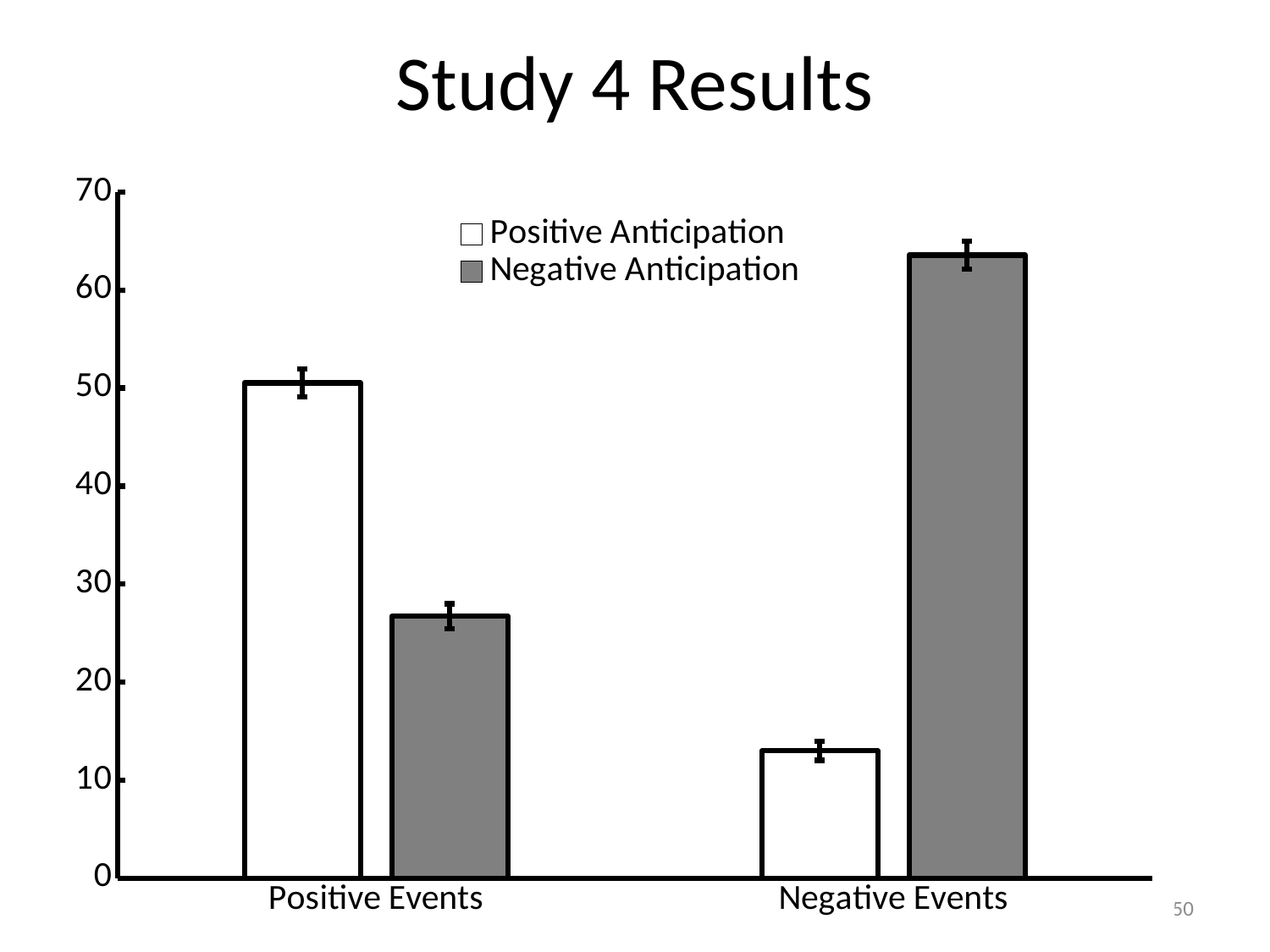
Is the value for Positive Anticipation in Negative Events greater or less than 20? less Is the value for Negative Anticipation in Positive Events greater or less than 30? less How many event categories are shown on the x axis? 2 For Positive Events, which is larger: Positive Anticipation or Negative Anticipation? Positive Anticipation Is the value for Positive Anticipation in Positive Events greater or less than 40? greater What is the title of the slide? Study 4 Results For Negative Events, which is larger: Positive Anticipation or Negative Anticipation? Negative Anticipation Which bar is the lowest on the chart? Positive Anticipation for Negative Events What kind of chart is shown on the slide? bar chart Which series has the tallest bar overall? Negative Anticipation How many series does the legend list? 2